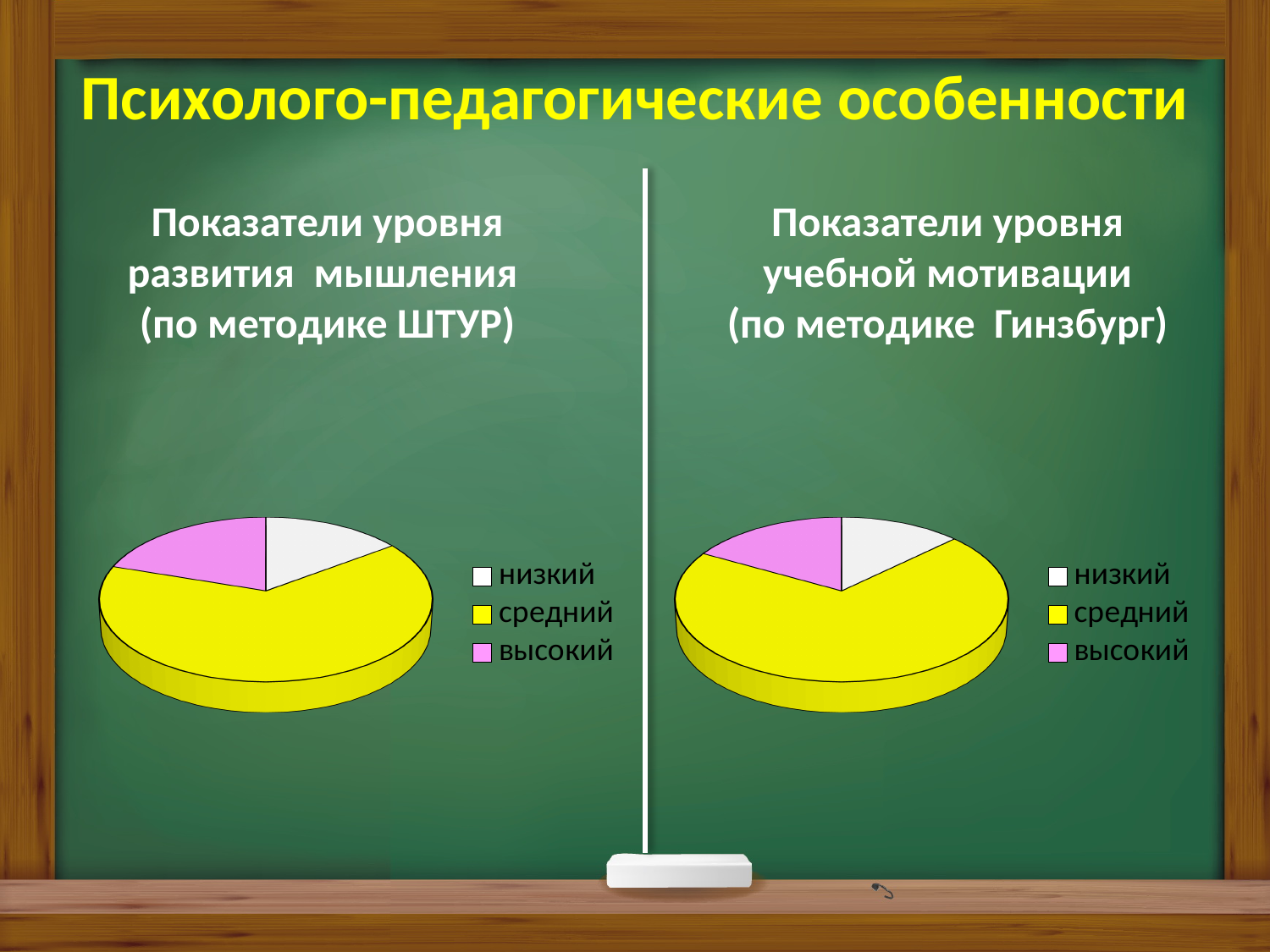
In the left chart (по методике ШТУР), which category has the smallest slice? низкий In the right chart (по методике Гинзбург), which category has the largest slice? средний In the right chart (по методике Гинзбург), what colour is the средний slice? yellow What kind of chart is the right chart (Показатели уровня учебной мотивации)? pie chart How many categories does the legend of the right chart list? 3 In the left chart (по методике ШТУР), which slice is larger: высокий or низкий? высокий How many pie charts are shown on the slide? 2 In the left chart (по методике ШТУР), what colour is the высокий slice? pink What kind of chart is the left chart (Показатели уровня развития мышления)? pie chart In the left chart (по методике ШТУР), which category has the largest slice? средний How many categories does the legend of the left chart list? 3